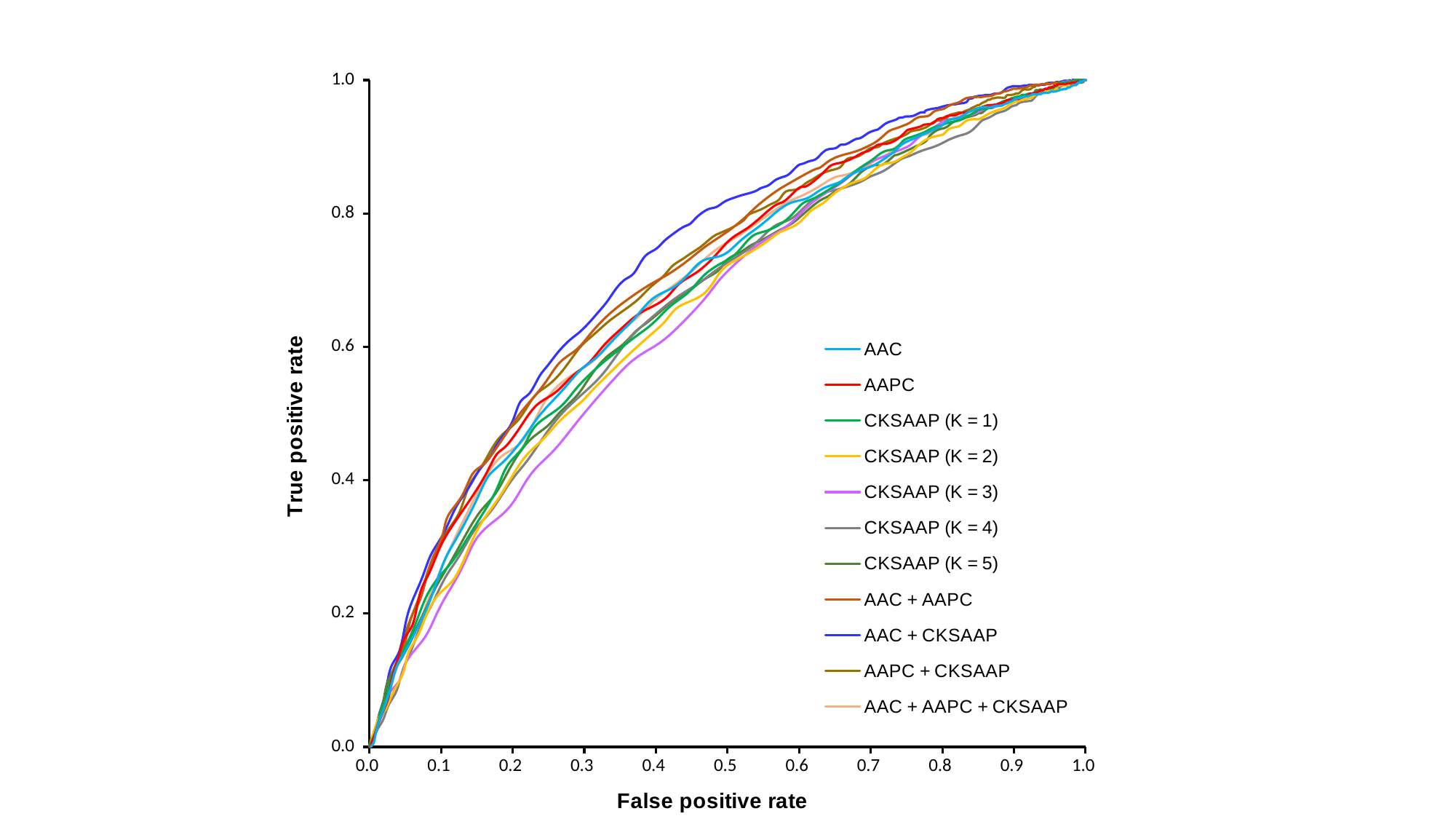
At a false positive rate of 0.1, is the true positive rate for AAC + CKSAAP greater or less than 0.2? greater Do the true positive rate values rise or fall as the false positive rate increases along the x axis? Rise What is the true positive rate of every series at a false positive rate of 1.0? 1.0 What is the label of the x axis? False positive rate At a false positive rate of 0.3, is the true positive rate for CKSAAP (K = 3) greater or less than 0.6? less Which series has the highest true positive rate at a false positive rate of 0.4? AAC + CKSAAP How many series does the legend list? 11 At a false positive rate of 0.4, which series has the larger true positive rate, AAC + CKSAAP or CKSAAP (K = 3)? AAC + CKSAAP At a false positive rate of 0.4, is the true positive rate for AAC + CKSAAP greater or less than 0.6? greater What kind of chart is shown on the slide? Line chart Which series has the lowest true positive rate at a false positive rate of 0.4? CKSAAP (K = 3) What is the label of the y axis? True positive rate